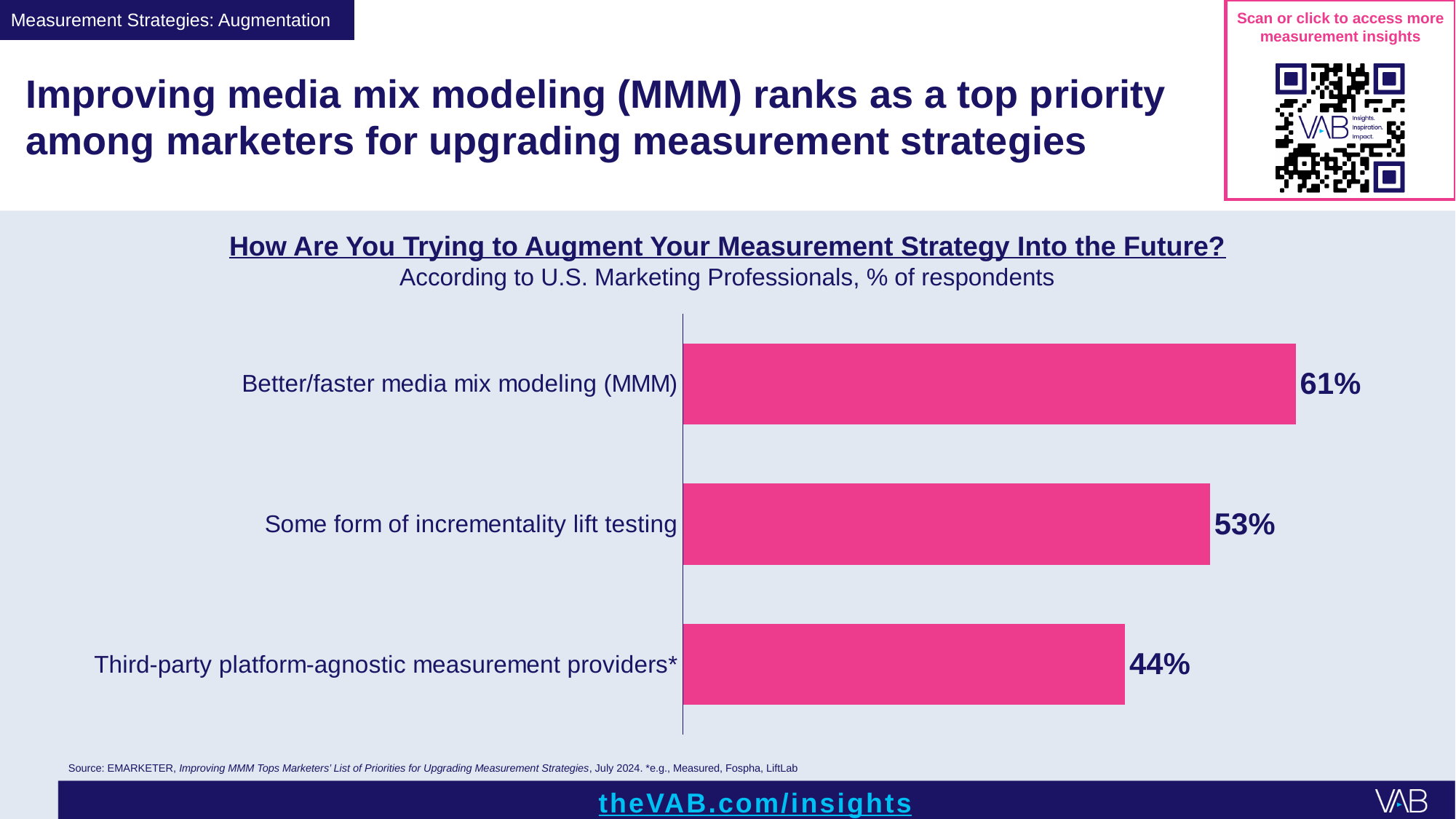
What kind of chart is shown on the slide? Bar chart What is the difference in percentage points between better/faster media mix modeling (MMM) and some form of incrementality lift testing? 8 percentage points What percentage of respondents cited third-party platform-agnostic measurement providers? 44% What percentage of respondents cited some form of incrementality lift testing? 53% Which category has the highest percentage of respondents? Better/faster media mix modeling (MMM) What percentage of respondents cited better/faster media mix modeling (MMM)? 61% What colour are the bars in the chart? Pink What is the difference in percentage points between better/faster media mix modeling (MMM) and third-party platform-agnostic measurement providers? 17 percentage points How many categories are shown in the chart? 3 Which has a larger share of respondents: some form of incrementality lift testing or third-party platform-agnostic measurement providers? Some form of incrementality lift testing What is the title of the chart? How Are You Trying to Augment Your Measurement Strategy Into the Future? Which category has the lowest percentage of respondents? Third-party platform-agnostic measurement providers*